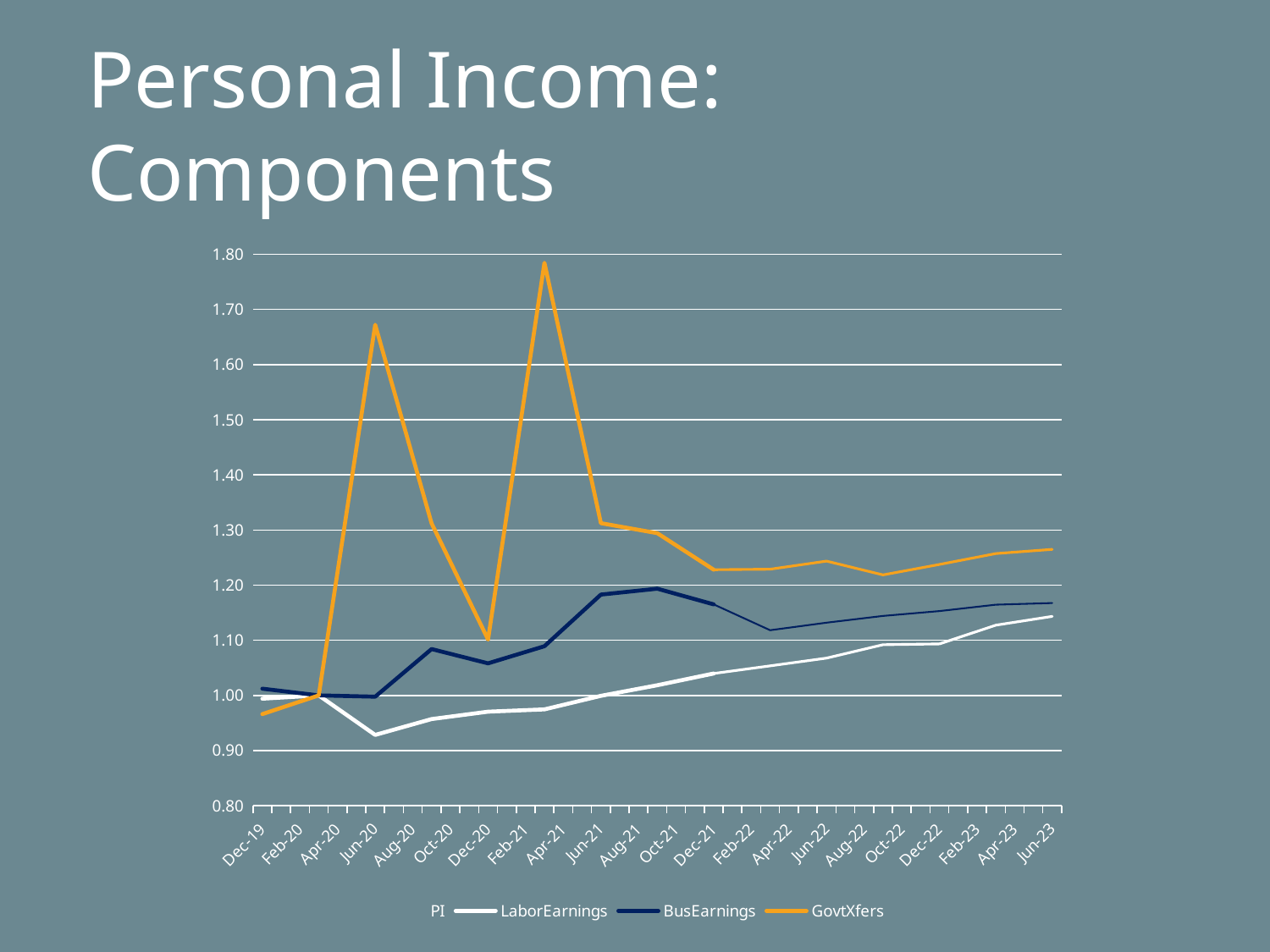
Is the value for BusEarnings at Oct-21 greater or less than 1.10? greater Is the value for GovtXfers at Jun-20 greater or less than 1.50? greater Is the value for LaborEarnings at Jun-20 greater or less than 1.00? less Does LaborEarnings rise or fall from Jun-20 to Jun-23? rise At Jun-21, which is larger: BusEarnings or LaborEarnings? BusEarnings At Jun-23, which is larger: GovtXfers or LaborEarnings? GovtXfers Which series has the lowest value at Jun-20? LaborEarnings What kind of chart is shown on the slide? line chart How many month labels are shown on the x axis? 22 What colour is the GovtXfers line? orange Which series reaches the highest value on the chart? GovtXfers